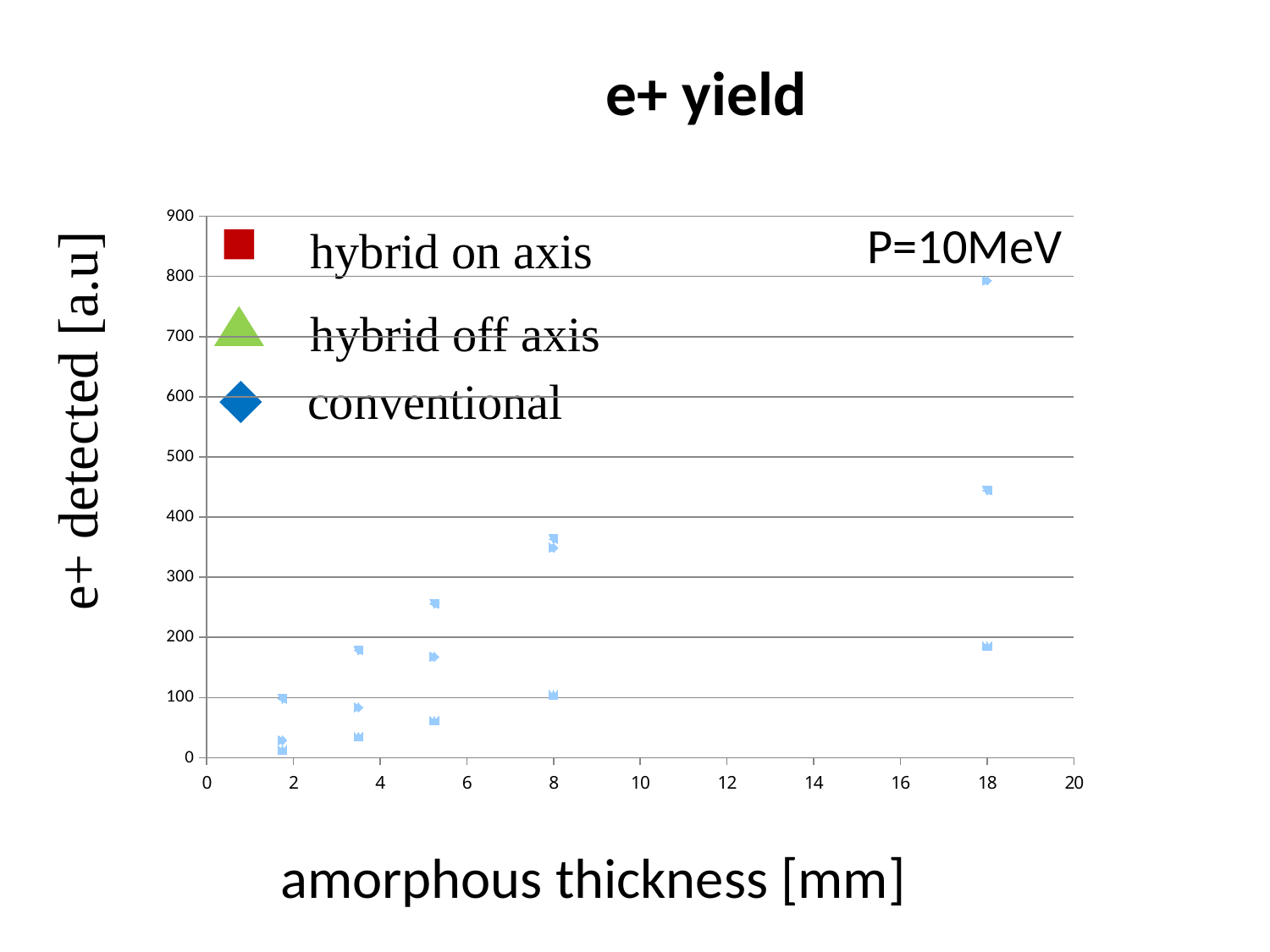
What is the label of the x axis? amorphous thickness [mm] What is the title of the chart? e+ yield At how many distinct thickness values are points plotted? 5 Is the lowest plotted value at a thickness of 8 mm greater or less than 200? less Is the lowest plotted value at a thickness of 18 mm greater or less than 200? less Do the highest plotted values rise or fall as the amorphous thickness increases? rise What kind of chart is shown on the slide? scatter chart Is the highest plotted value at a thickness of 8 mm greater or less than 300? greater How many series does the legend list? 3 Which thickness has the highest plotted value overall? 18